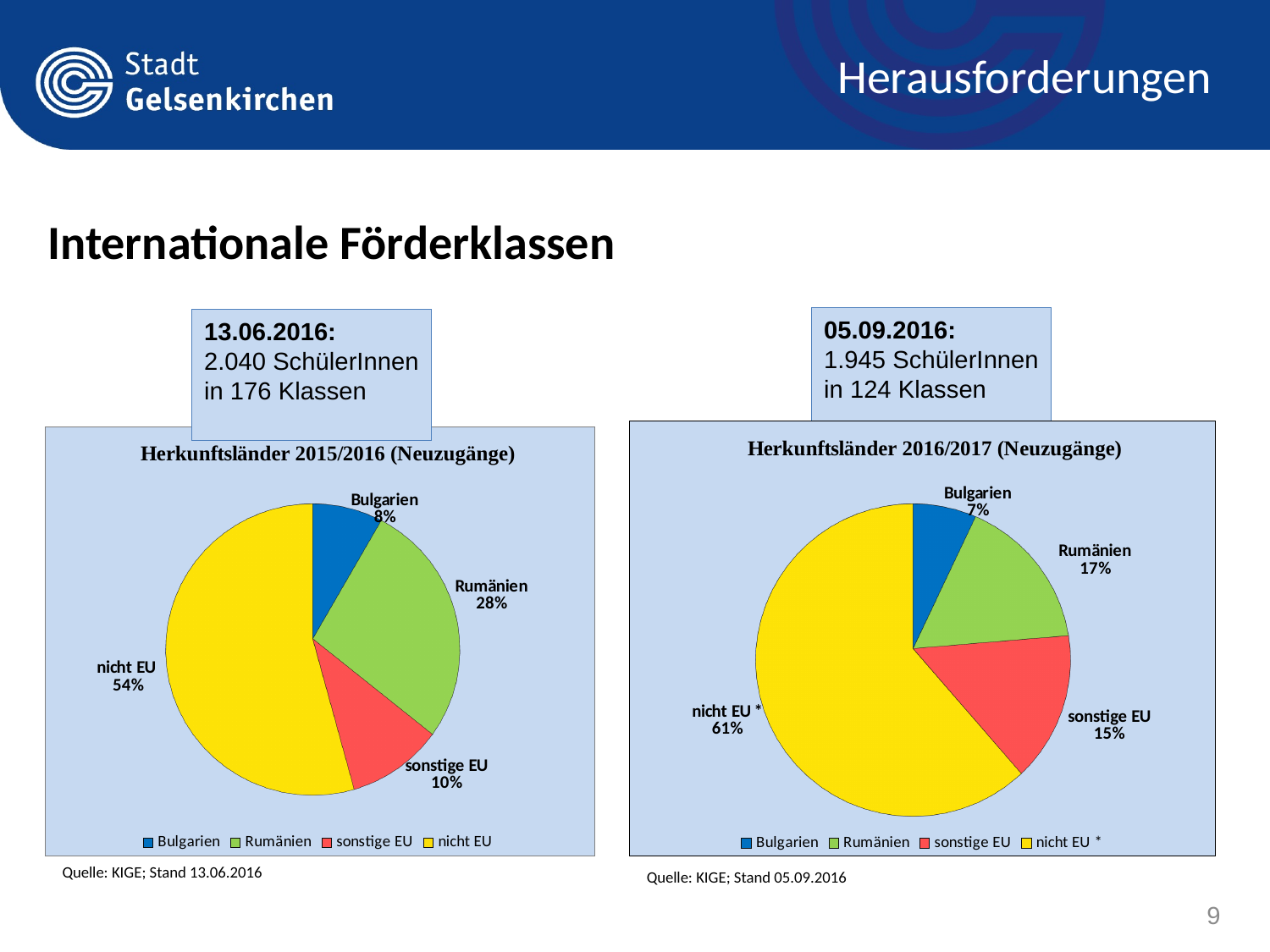
In the chart 'Herkunftsländer 2016/2017 (Neuzugänge)', which is larger: the share of Rumänien or the share of sonstige EU? Rumänien In the chart 'Herkunftsländer 2016/2017 (Neuzugänge)', which category has the smallest slice? Bulgarien How many entries does the legend of the chart 'Herkunftsländer 2016/2017 (Neuzugänge)' list? 4 In the chart 'Herkunftsländer 2015/2016 (Neuzugänge)', what share does Rumänien have? 28% In the chart 'Herkunftsländer 2016/2017 (Neuzugänge)', what share does nicht EU * have? 61% In the chart 'Herkunftsländer 2015/2016 (Neuzugänge)', what is the difference between the shares of Rumänien and sonstige EU? 18% What kind of chart is 'Herkunftsländer 2015/2016 (Neuzugänge)'? pie chart In the chart 'Herkunftsländer 2016/2017 (Neuzugänge)', what share does Bulgarien have? 7% In the chart 'Herkunftsländer 2015/2016 (Neuzugänge)', what colour is the slice for sonstige EU? red How many slices does the chart 'Herkunftsländer 2015/2016 (Neuzugänge)' have? 4 What is the title of the pie chart on the right side of the slide? Herkunftsländer 2016/2017 (Neuzugänge) In the chart 'Herkunftsländer 2015/2016 (Neuzugänge)', which category has the largest slice? nicht EU